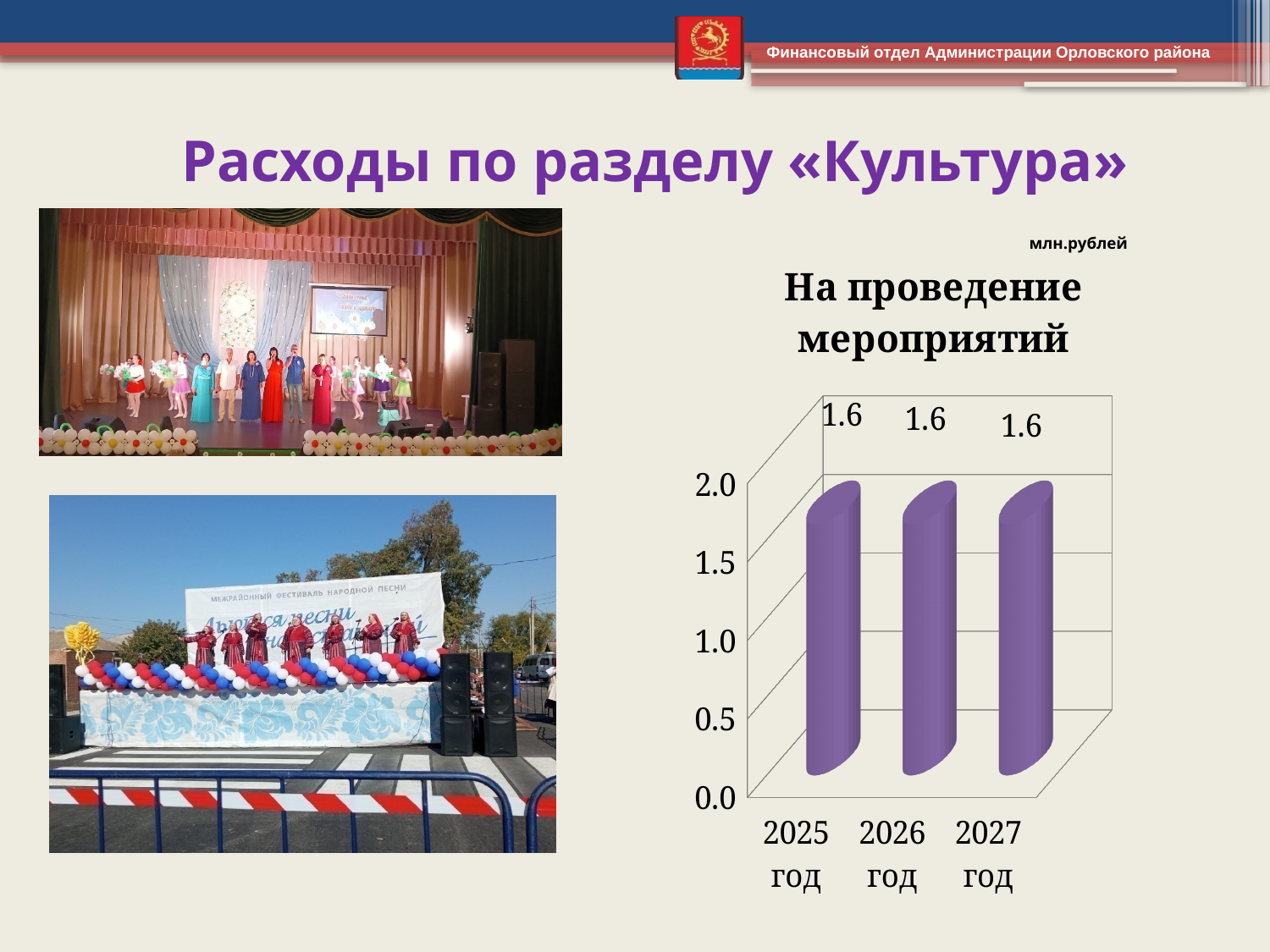
In what units are the chart values given? млн.рублей How many categories (years) are shown on the x axis of the chart? 3 Is the value for 2026 год greater or less than 1.5? greater Do the values rise, fall or stay the same from 2025 год to 2027 год? stay the same What is the value for 2025 год in the chart? 1.6 What kind of chart is shown on the slide? bar chart What is the difference between the values for 2025 год and 2027 год? 0.0 What is the value for 2027 год in the chart? 1.6 Is the value for 2027 год greater or less than 2.0? less What is the value for 2026 год in the chart? 1.6 What is the title of the chart? На проведение мероприятий